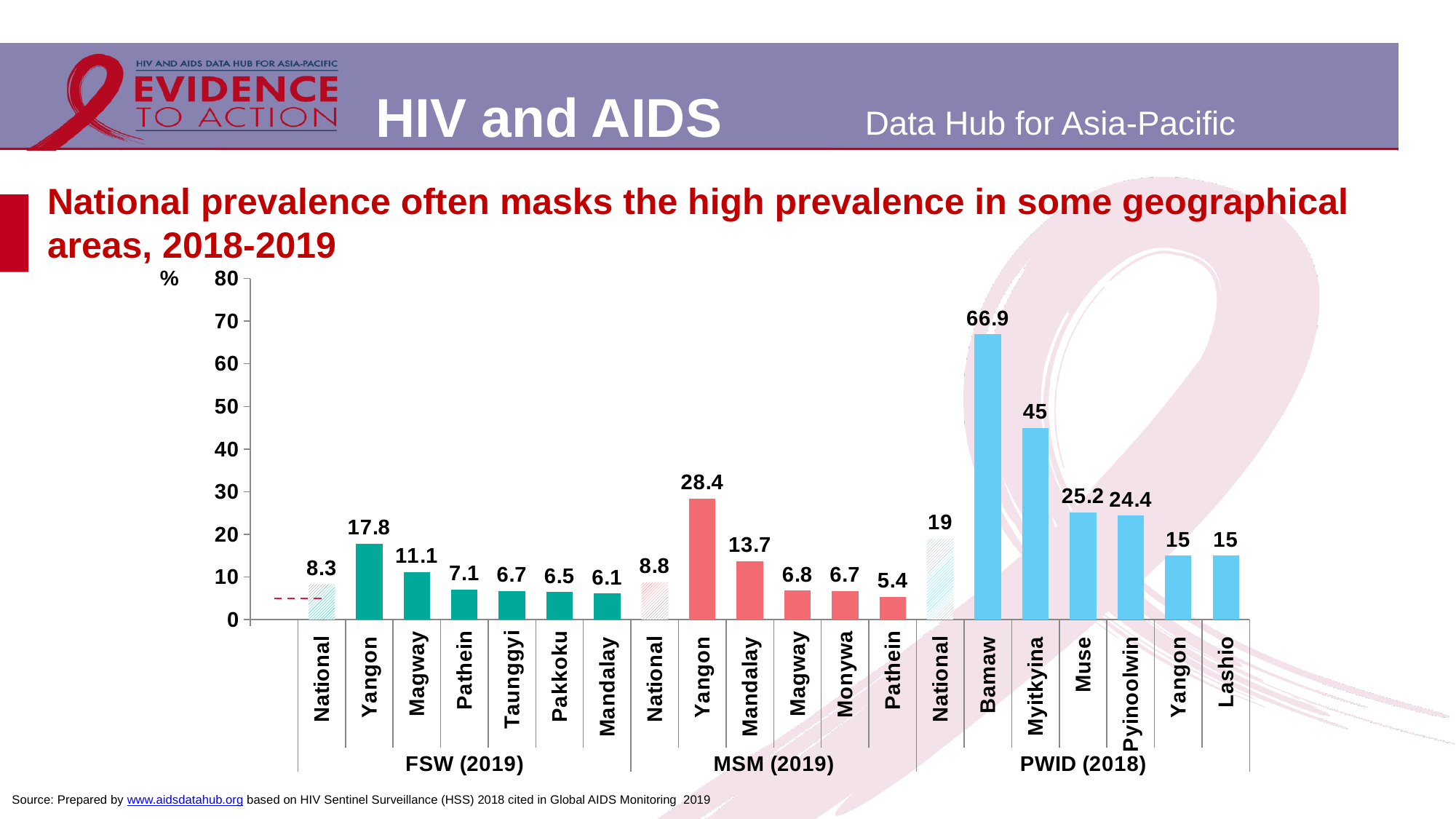
Which is larger: the Yangon value in the FSW (2019) group or the Yangon value in the MSM (2019) group? Yangon in MSM (2019) Is the value for Myitkyina greater or less than 40? greater How many bars are plotted in the chart in total? 20 What is the value for Bamaw in the PWID (2018) group? 66.9 What type of chart is shown on the slide? bar chart What is the difference between the Bamaw value and the National value in the PWID (2018) group? 47.9 Which location has the highest value across the whole chart? Bamaw What unit is shown on the vertical axis of the chart? % What is the difference between the Magway value in the FSW (2019) group and the Magway value in the MSM (2019) group? 4.3 What is the National value in the FSW (2019) group? 8.3 Which location has the lowest value in the MSM (2019) group? Pathein What is the value for Yangon in the MSM (2019) group? 28.4